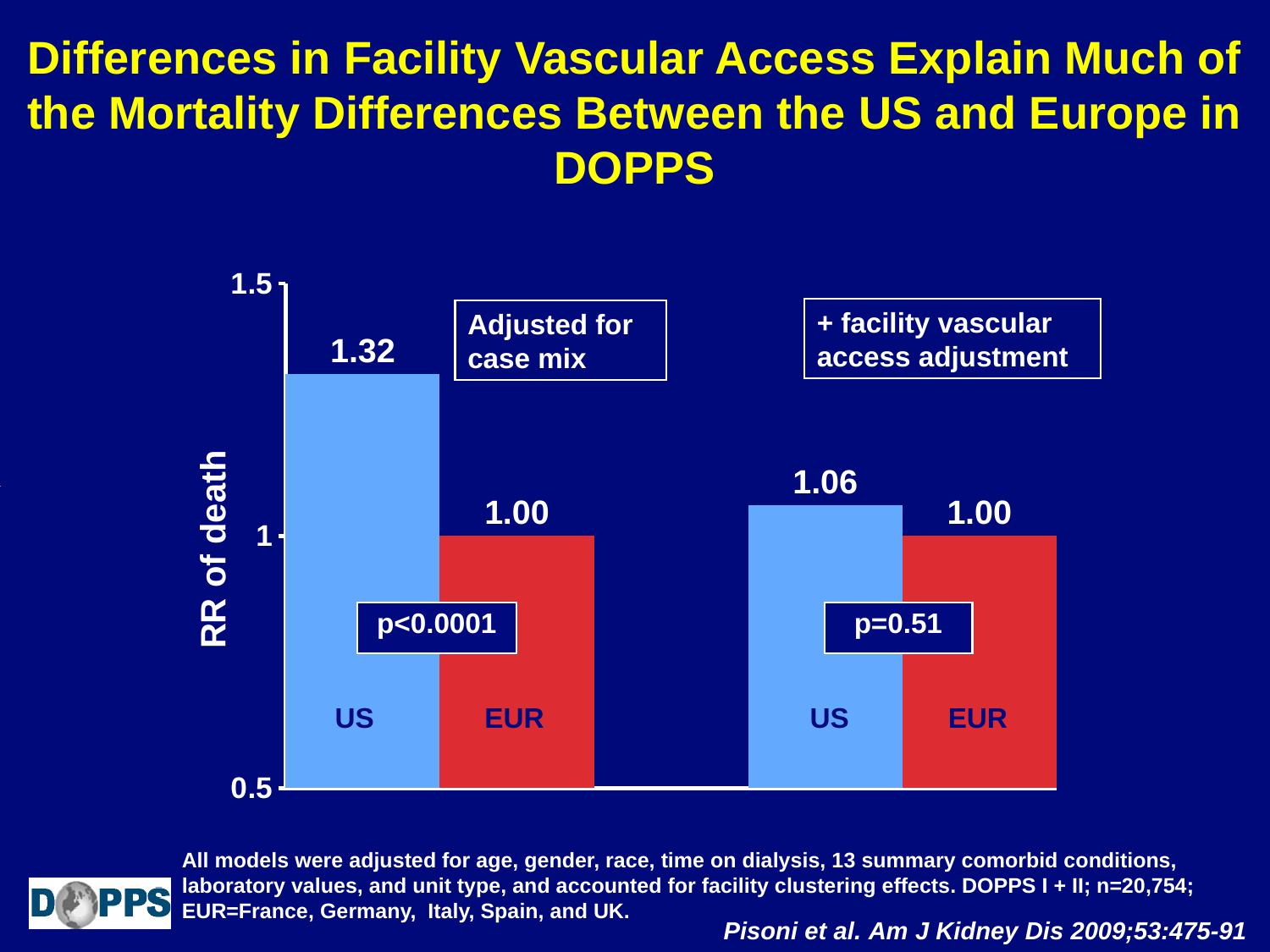
What is the difference between the US RR of death adjusted for case mix and the US RR of death with the facility vascular access adjustment? 0.26 What p-value is shown for the US versus EUR comparison after the facility vascular access adjustment? p=0.51 What is the RR of death for the US in the model adjusted for case mix? 1.32 How many bars are plotted in the chart? 4 What kind of chart is shown on the slide? Bar chart What is the RR of death for EUR in the model adjusted for case mix? 1.00 What is the RR of death for the US after adding the facility vascular access adjustment? 1.06 Which is larger, the US RR of death adjusted for case mix or the US RR of death with the facility vascular access adjustment? US adjusted for case mix What is the label of the y axis? RR of death What is the difference between the US and EUR RR of death in the model adjusted for case mix? 0.32 Which bar has the highest RR of death? US, adjusted for case mix Is the US RR of death adjusted for case mix greater or less than 1? greater